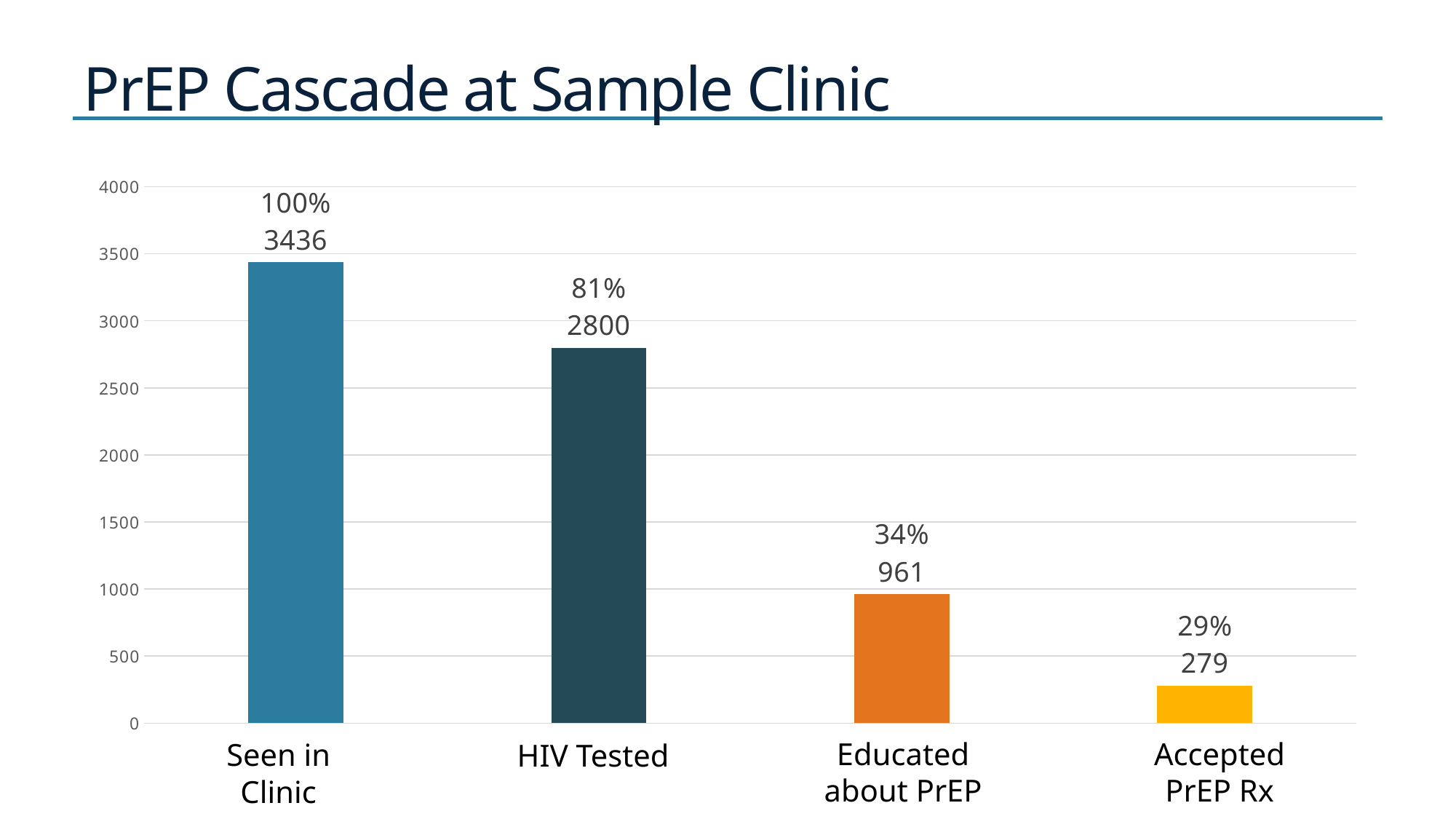
What is the difference between the values for Educated about PrEP and Accepted PrEP Rx? 682 What is the difference between the values for Seen in Clinic and HIV Tested? 636 Do the values rise or fall from left to right along the x axis? Fall Which category has the highest value? Seen in Clinic How many categories are shown on the x axis? 4 What is the value for HIV Tested? 2800 What is the value for Seen in Clinic? 3436 Which is larger, the value for HIV Tested or the value for Educated about PrEP? HIV Tested What kind of chart is shown on the slide? Bar chart What percentage is shown above the Accepted PrEP Rx bar? 29% What is the value for Educated about PrEP? 961 Which category has the lowest value? Accepted PrEP Rx